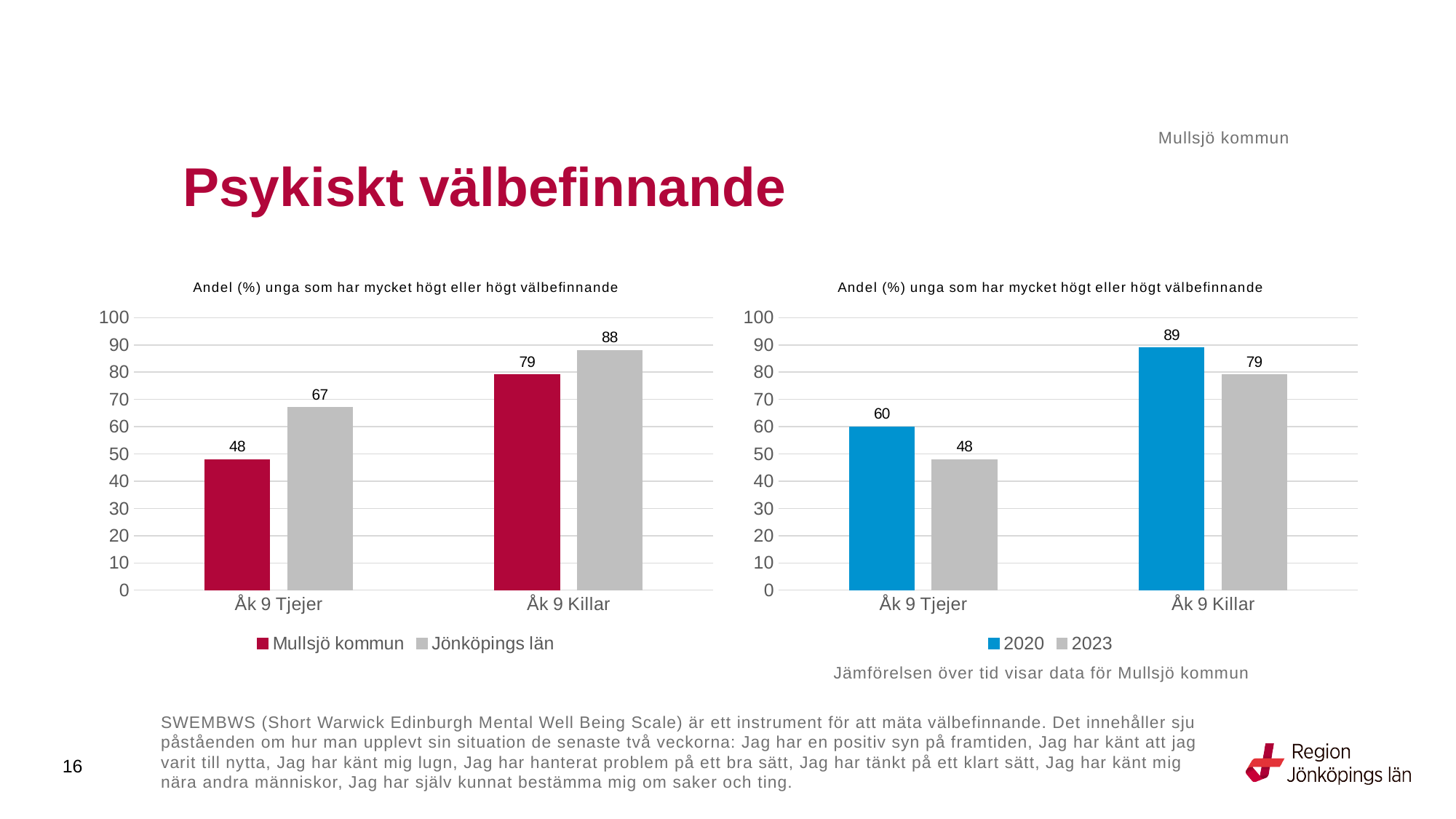
In the right chart, what is the difference between 2020 and 2023 for Åk 9 Killar? 10 In the right chart, what is the value for 2023 for Åk 9 Tjejer? 48 What are the two series in the legend of the left chart? Mullsjö kommun and Jönköpings län In the left chart, what is the value for Mullsjö kommun for Åk 9 Tjejer? 48 In the left chart, what is the value for Jönköpings län for Åk 9 Killar? 88 What kind of chart is the left chart? Bar chart In the right chart, which bar has the lowest value? 2023 for Åk 9 Tjejer In the left chart, which category has the highest value for Mullsjö kommun? Åk 9 Killar In the left chart, what is the difference between Jönköpings län and Mullsjö kommun for Åk 9 Tjejer? 19 How many series does the legend of the right chart list? 2 In the right chart, which is larger for Åk 9 Tjejer, 2020 or 2023? 2020 In the right chart, what is the value for 2020 for Åk 9 Killar? 89